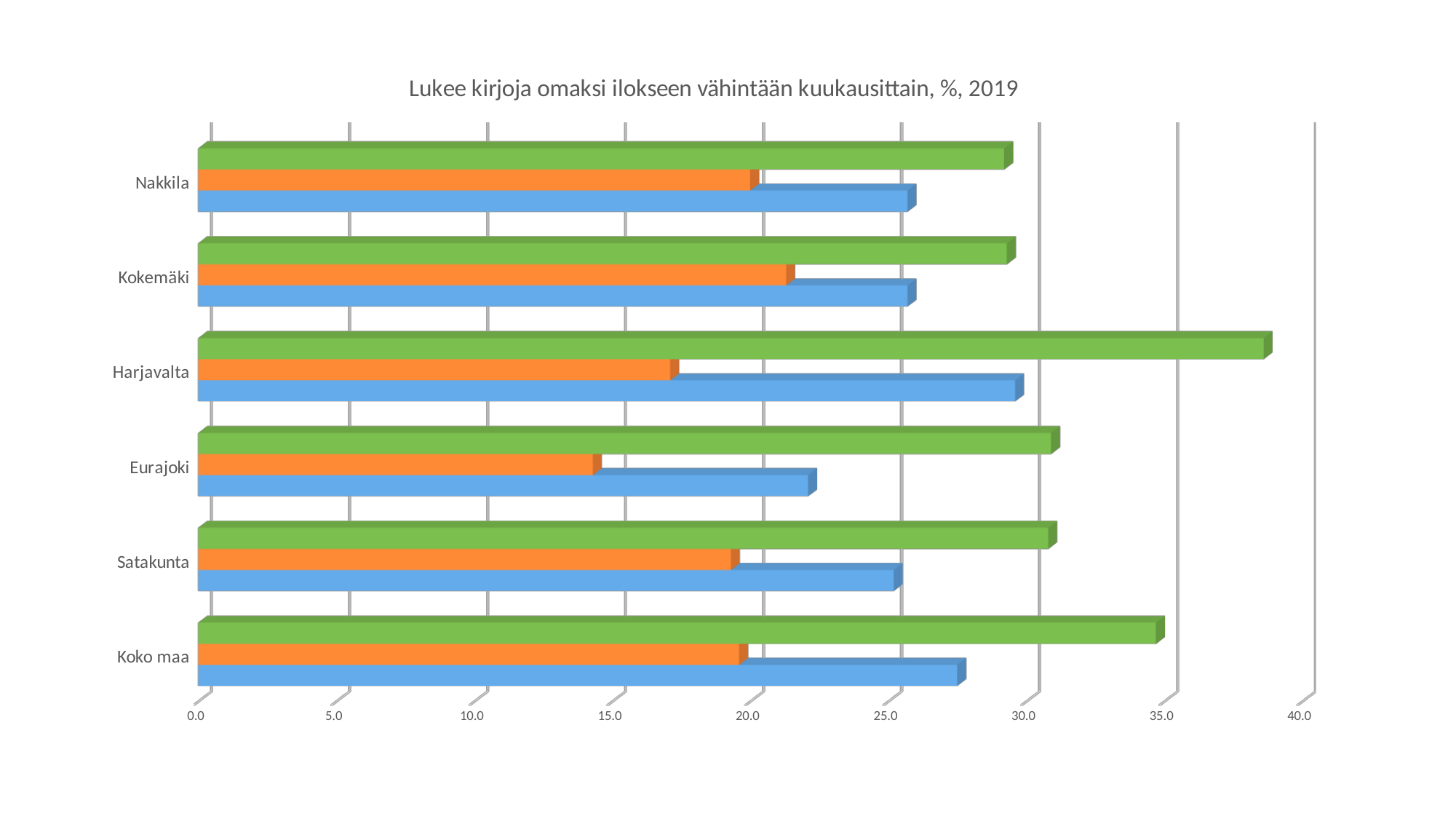
Is the green bar for Koko maa greater or less than 30.0? greater Which category has the shortest orange bar? Eurajoki Is the orange bar for Eurajoki greater or less than 15.0? less Is the green bar for Harjavalta greater or less than 35.0? greater What kind of chart is shown on the slide? bar chart What is the title of the chart? Lukee kirjoja omaksi ilokseen vähintään kuukausittain, %, 2019 How many bars are plotted for each category in the chart? 3 Which category has the longest green bar? Harjavalta Which is larger, the blue bar for Nakkila or the blue bar for Eurajoki? Nakkila Which category has the shortest blue bar? Eurajoki How many categories are shown on the vertical axis of the chart? 6 Which is larger, the orange bar for Kokemäki or the orange bar for Harjavalta? Kokemäki